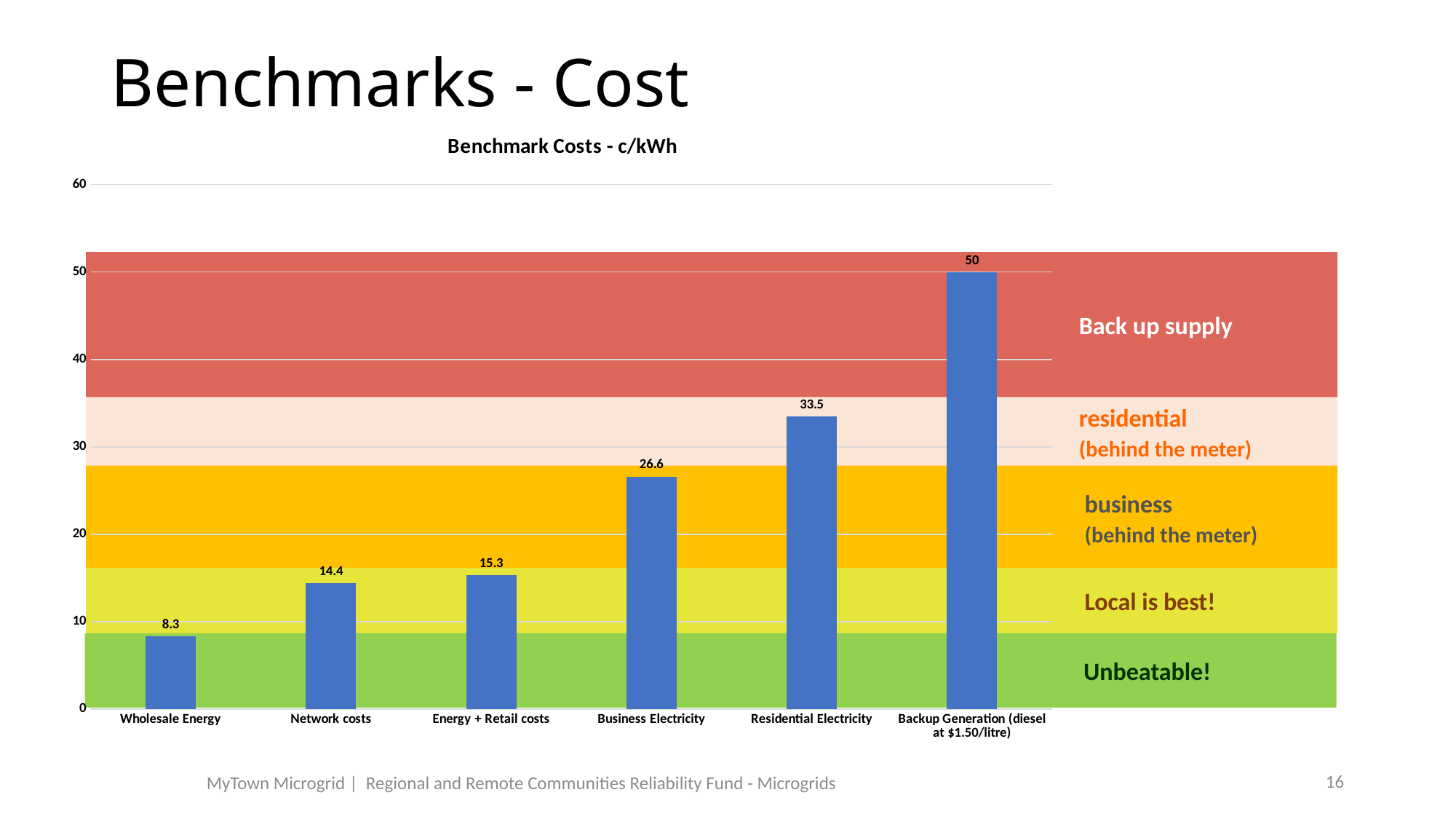
What is the value for Business Electricity? 26.6 Which category has the highest value? Backup Generation (diesel at $1.50/litre) Is the value for Business Electricity greater or less than 20? greater What is the title of the chart? Benchmark Costs - c/kWh What is the difference between Energy + Retail costs and Network costs? 0.9 How many categories are shown on the x axis? 6 What kind of chart is this? bar chart What is the value for Residential Electricity? 33.5 Which category has the lowest value? Wholesale Energy What is the value for Wholesale Energy? 8.3 What is the difference between Backup Generation and Residential Electricity? 16.5 Which is larger, Business Electricity or Residential Electricity? Residential Electricity